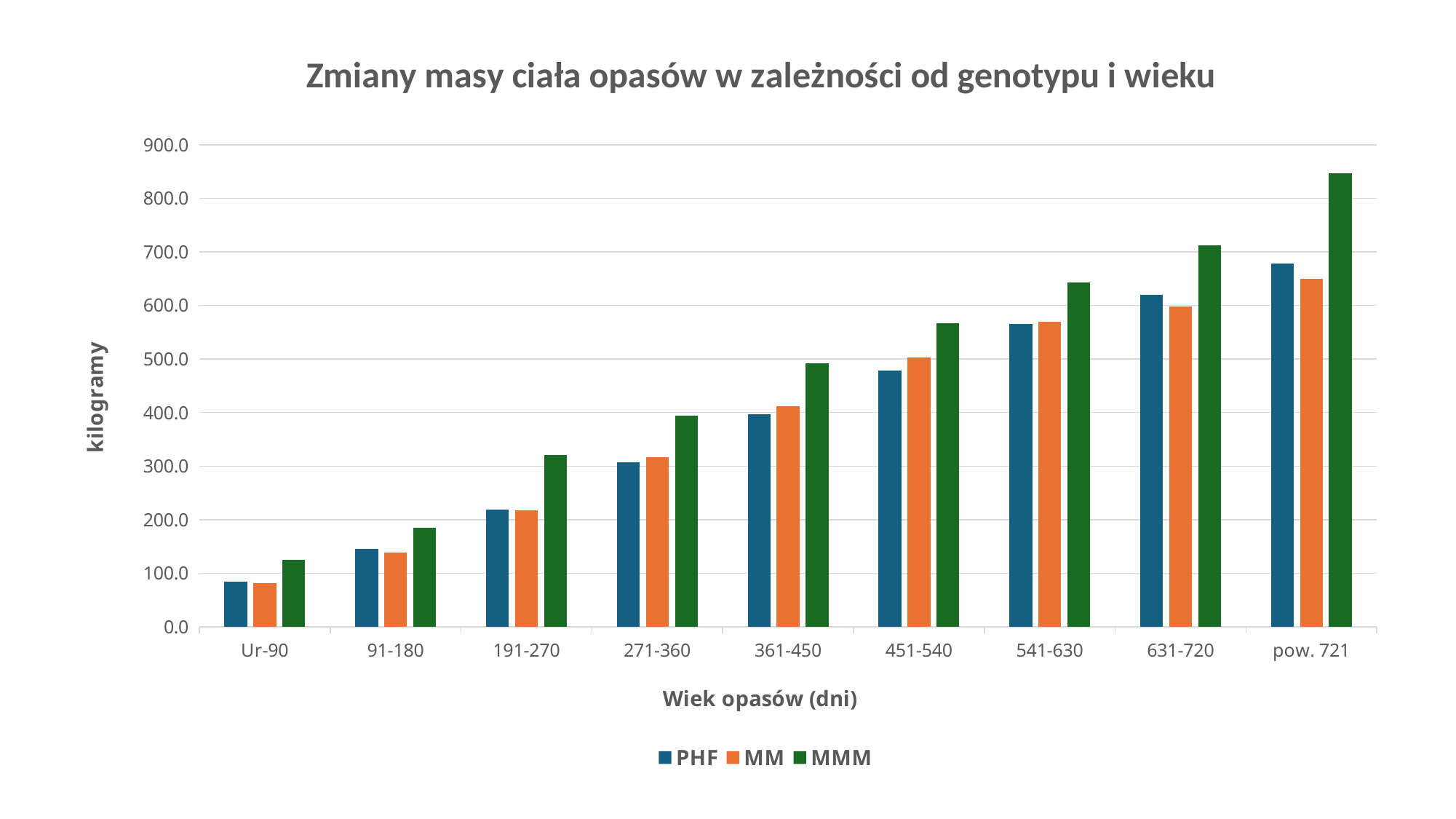
Do the MMM values rise or fall as age increases along the x axis? rise Is the MMM value for 541-630 greater or less than 600? greater Is the PHF value for 451-540 greater or less than 500? less Is the MMM value for 191-270 greater or less than 300? greater What is the title of the y axis? kilogramy For the pow. 721 age group, which series has the larger value, PHF or MM? PHF How many age groups are shown on the x axis? 9 Which age group has the highest value for the MMM series? pow. 721 Which age group has the lowest value for the PHF series? Ur-90 What kind of chart is shown on the slide? bar chart How many series does the legend list? 3